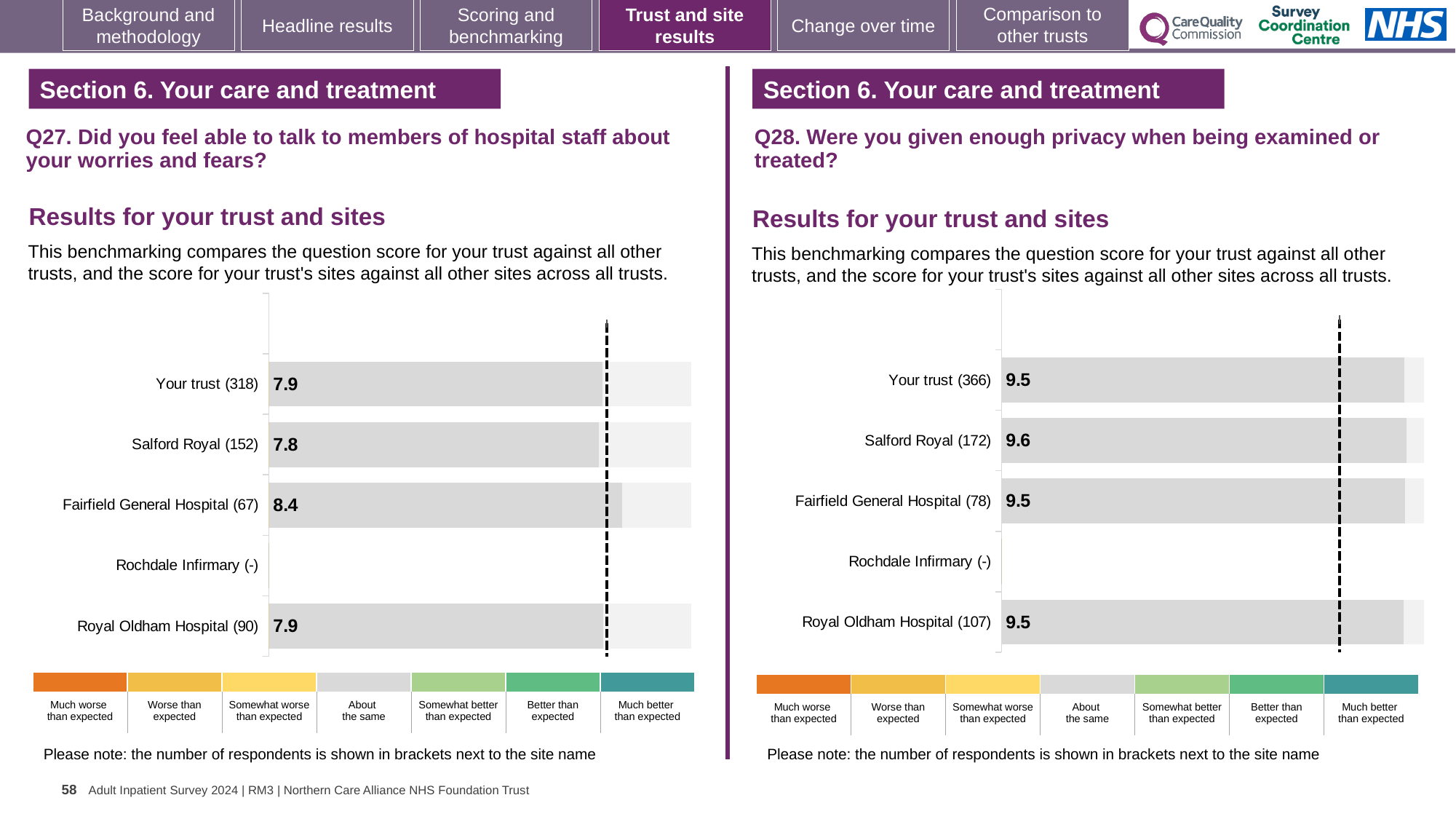
What type of chart is used on the left for Q27? bar chart In the Q28 chart on the right, is the score for Salford Royal higher or lower than the score for Your trust? higher In the Q28 chart on the right, what is the score for Salford Royal? 9.6 In the Q27 chart on the left, how many respondents are shown for Royal Oldham Hospital? 90 In the Q28 chart on the right, what is the score for Royal Oldham Hospital? 9.5 In the Q27 chart on the left, what is the score for Fairfield General Hospital? 8.4 In the Q28 chart on the right, how many rows (sites including Your trust) are listed? 5 In the Q27 chart on the left, which site has the highest score? Fairfield General Hospital In the Q27 chart on the left, which site has the lowest score? Salford Royal In the Q27 chart on the left, what is the score for Your trust? 7.9 In the Q27 chart on the left, what is the difference between the scores for Fairfield General Hospital and Salford Royal? 0.6 In the Q28 chart on the right, which site has the highest score? Salford Royal